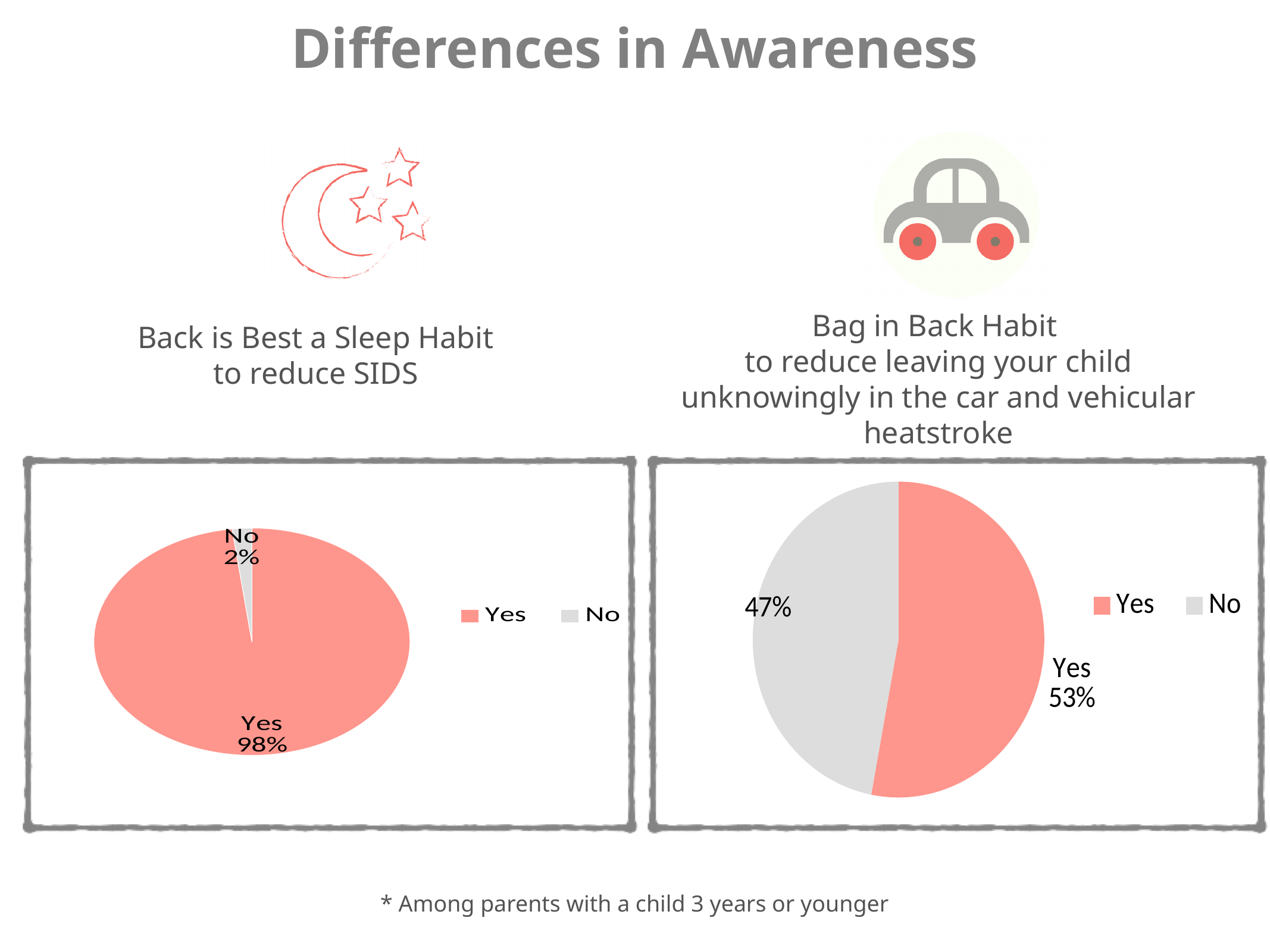
In the left pie chart (Back is Best), what is the difference between the Yes and No percentages? 96% In the right pie chart (Bag in Back Habit), what percentage of parents answered No? 47% In the right pie chart (Bag in Back Habit), what colour represents the No slice? Grey In the left pie chart (Back is Best), which slice is the smallest? No What type of chart is used on the left side of the slide? Pie chart In the left pie chart (Back is Best), what percentage of parents answered No? 2% In the left pie chart (Back is Best), what percentage of parents answered Yes? 98% In the right pie chart (Bag in Back Habit), what is the difference between the Yes and No percentages? 6% How many entries does the legend of the left pie chart list? 2 In the right pie chart (Bag in Back Habit), which slice is larger, Yes or No? Yes In the right pie chart (Bag in Back Habit), what percentage of parents answered Yes? 53% How many slices does the right pie chart (Bag in Back Habit) have? 2